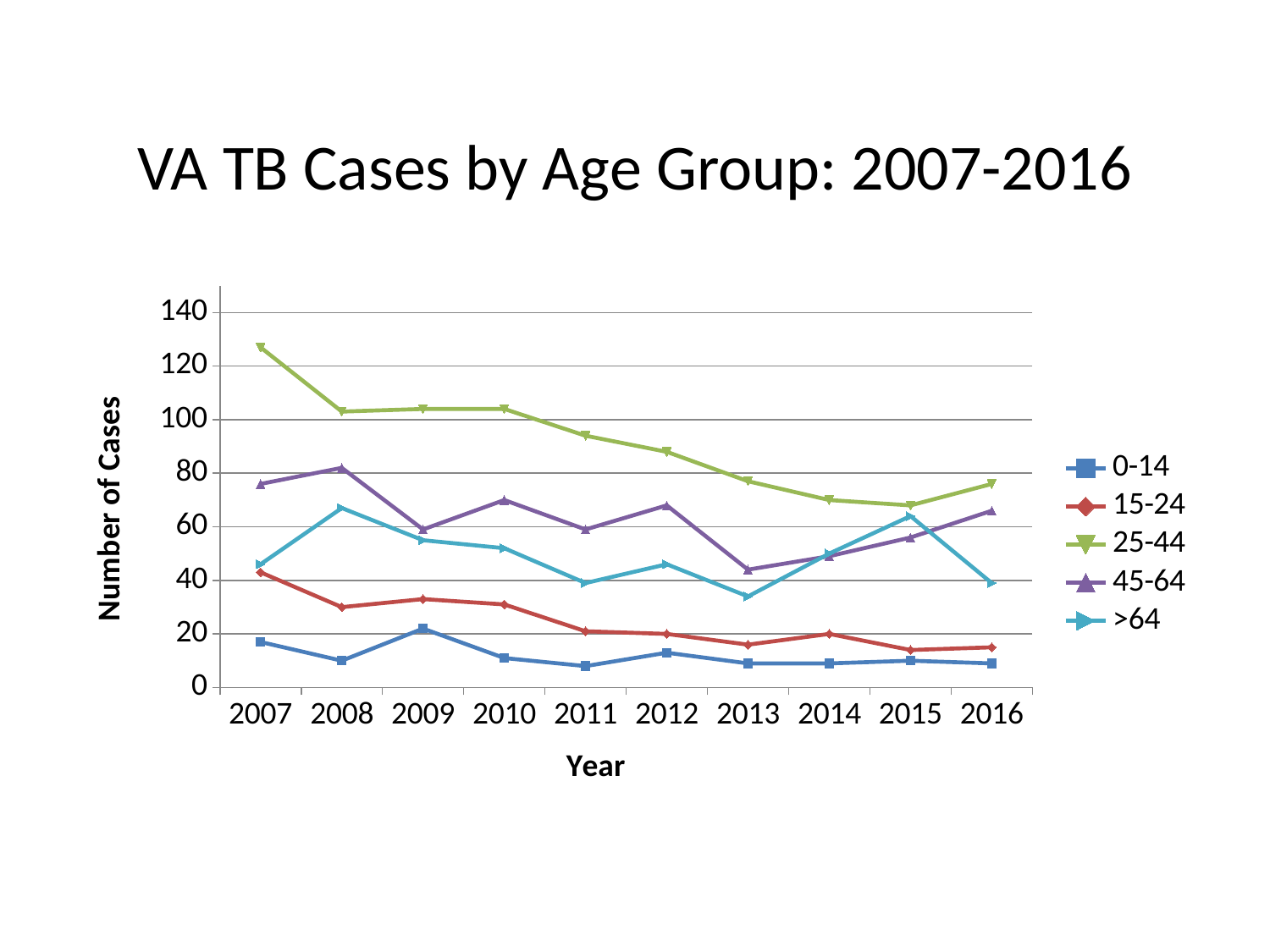
What kind of chart is shown on the slide? line chart Which age group has the highest number of cases in 2016? 25-44 In 2008, which has more cases: the 45-64 age group or the >64 age group? 45-64 What is the title of the y axis? Number of Cases Is the value for the 25-44 age group in 2015 greater or less than 80? less In which year does the 25-44 age group have its highest number of cases? 2007 How many series does the legend list? 5 Is the value for the 25-44 age group in 2007 greater or less than 120? greater Does the number of cases for the 25-44 age group rise or fall from 2007 to 2015? fall Which age group has the lowest number of cases in 2011? 0-14 How many years are plotted along the x axis? 10 Is the value for the >64 age group in 2013 greater or less than 40? less